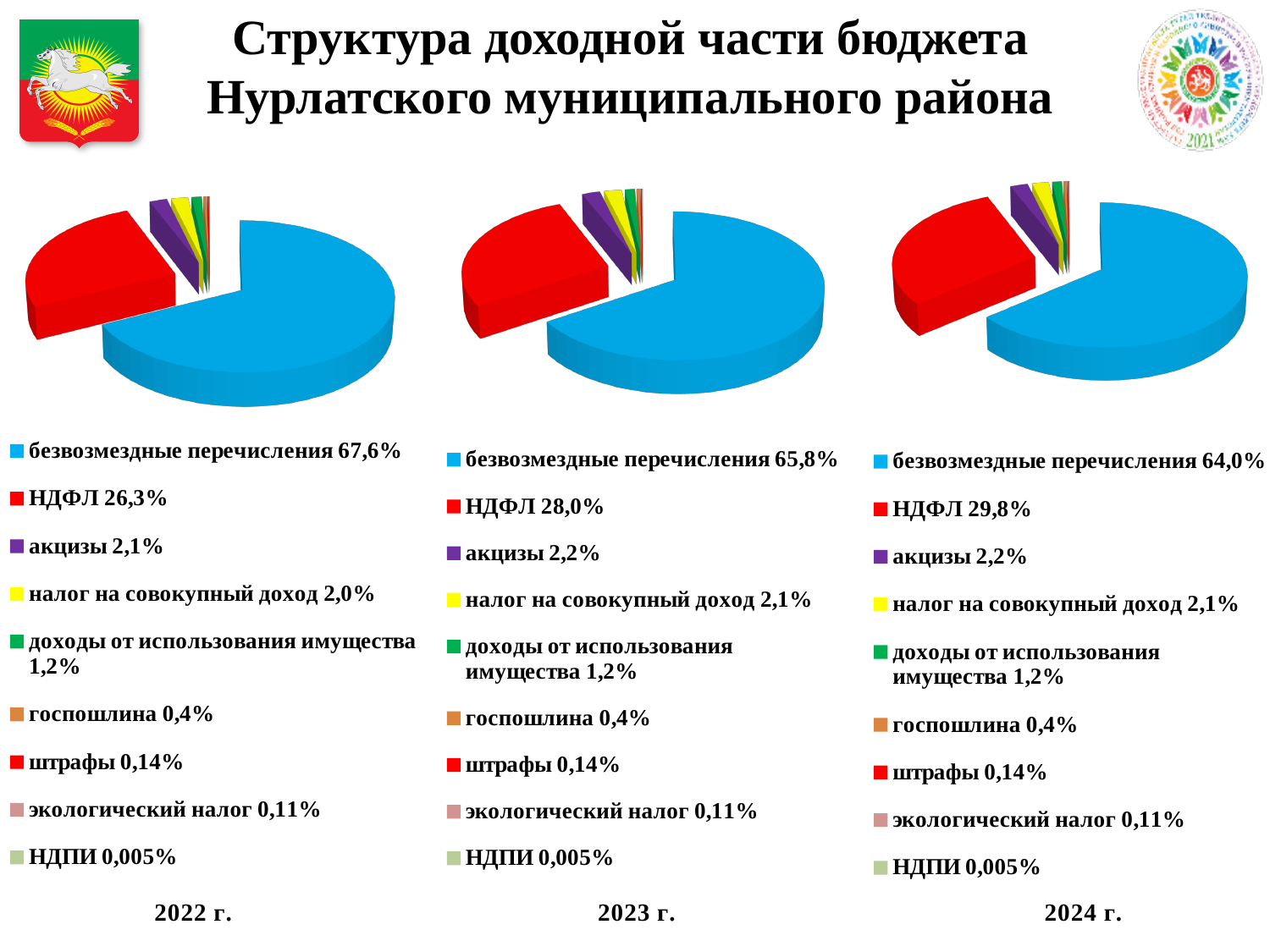
In the 2022 г. pie chart, what colour is the slice for безвозмездные перечисления? blue In the 2023 г. pie chart, what is the difference between безвозмездные перечисления and НДФЛ? 37,8% In the 2022 г. pie chart, which category has the smallest share? НДПИ In the 2022 г. pie chart, what share is безвозмездные перечисления? 67,6% How many categories does the legend of the 2023 г. pie chart list? 9 In the 2023 г. pie chart, what is the value for НДФЛ? 28,0% In the 2022 г. pie chart, which is larger: акцизы or налог на совокупный доход? акцизы In the 2024 г. pie chart, which category has the largest share? безвозмездные перечисления What kind of chart is used for 2024 г.? pie chart Which year's pie chart shows the highest share for НДФЛ: 2022 г., 2023 г. or 2024 г.? 2024 г. In the 2024 г. pie chart, what is the value for госпошлина? 0,4% In the 2024 г. pie chart, what is the value for акцизы? 2,2%